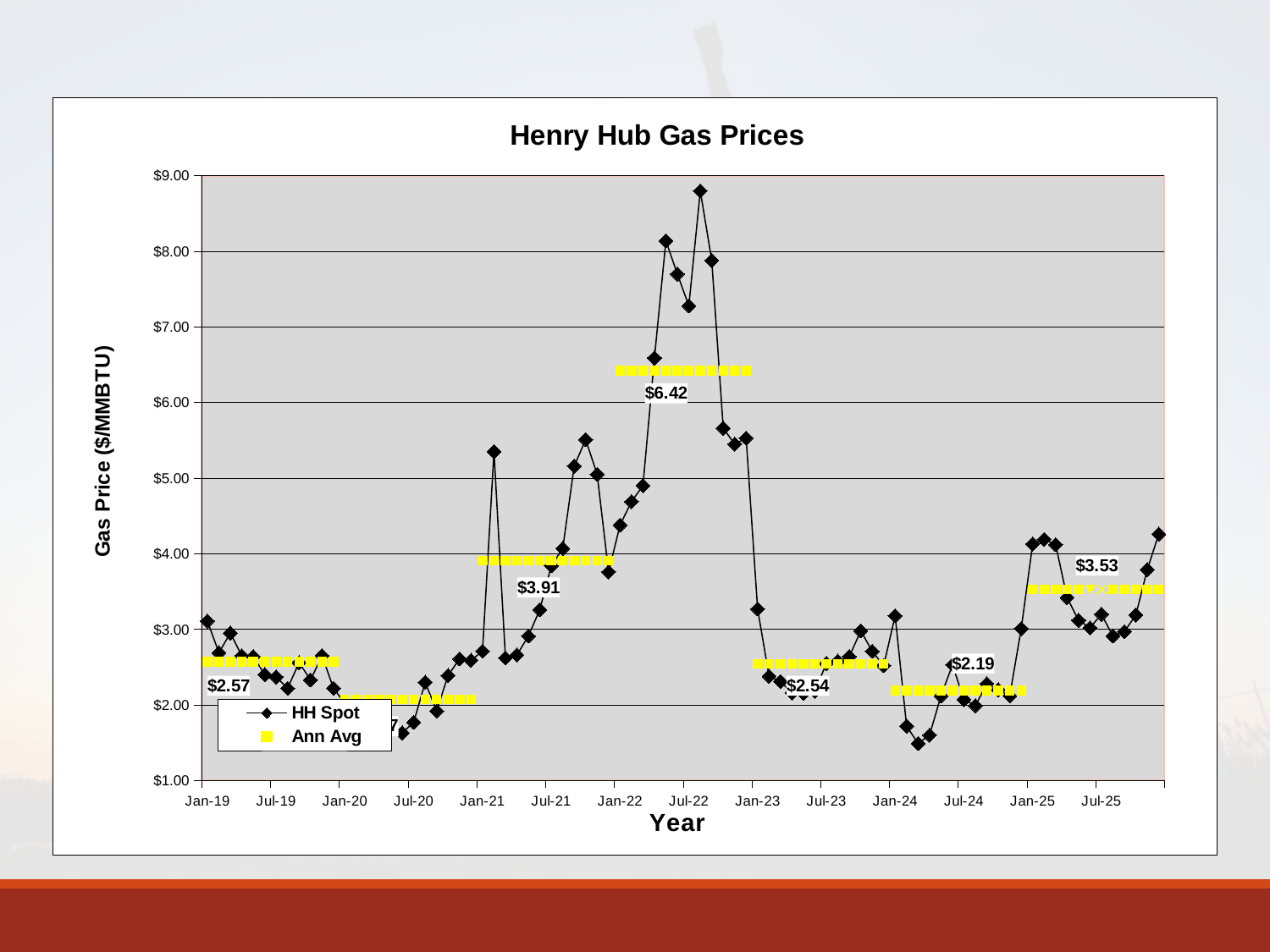
What is the annual average Henry Hub gas price labelled for 2025? $3.53 What is the annual average Henry Hub gas price labelled for 2021? $3.91 Is the peak HH Spot value in 2022 greater or less than $8.00? greater Which year has the highest labelled annual average gas price? 2022 What kind of chart is shown on the slide? line chart What is the difference between the 2022 annual average ($6.42) and the 2023 annual average ($2.54)? $3.88 What is the annual average Henry Hub gas price labelled for 2024? $2.19 What is the annual average Henry Hub gas price labelled for 2022? $6.42 Which is larger, the 2019 annual average or the 2023 annual average? 2019 annual average ($2.57) How many series does the legend list? 2 What is the title of the chart? Henry Hub Gas Prices What is the label on the y axis? Gas Price ($/MMBTU)